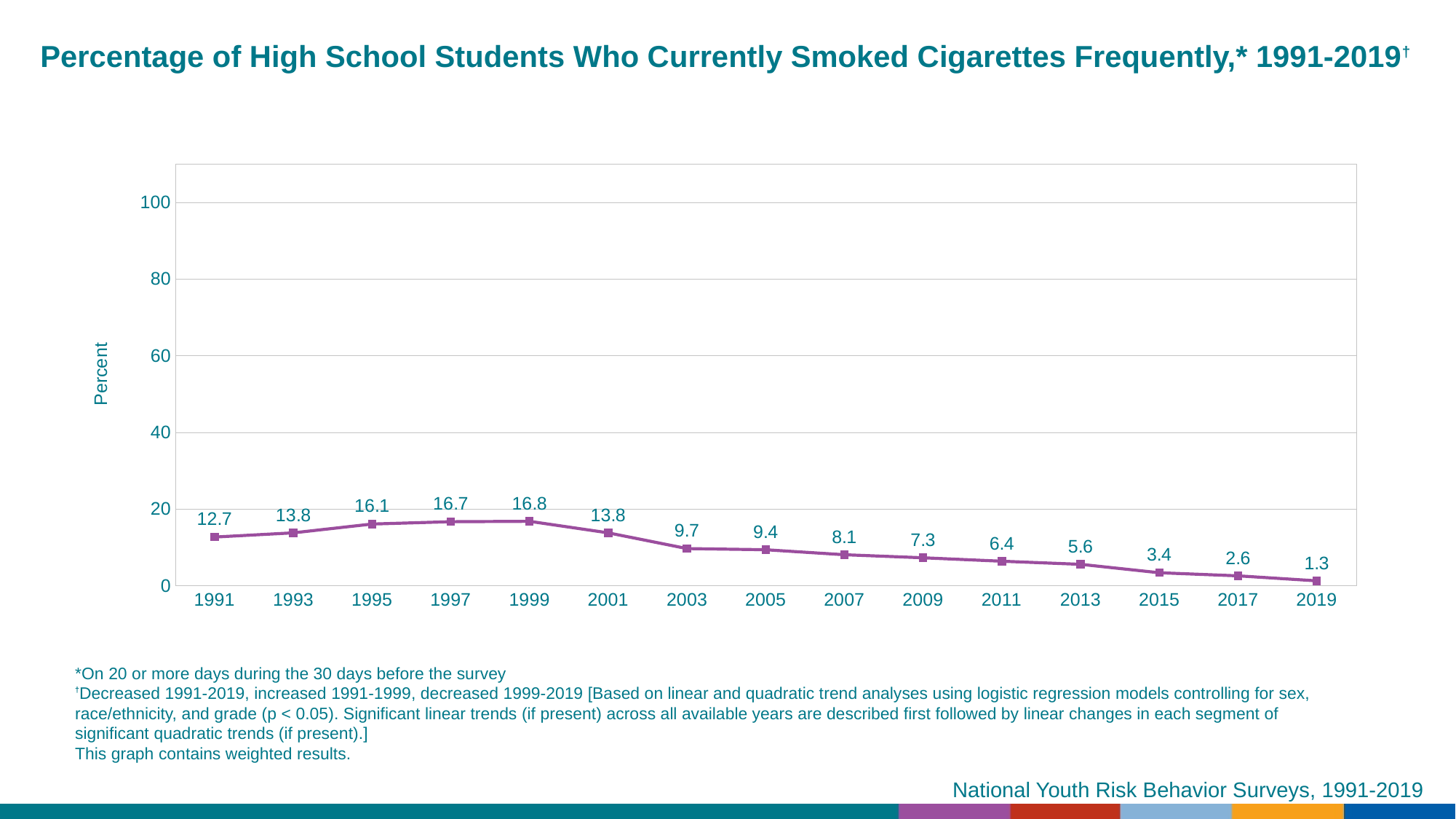
What is the difference between the values for 1991 and 2019? 11.4 How many years are plotted on the x axis? 15 What is the value plotted for 2007? 8.1 What percentage of high school students currently smoked cigarettes frequently in 1999? 16.8 Do the values rise or fall from 1999 to 2019? fall What is the value plotted for 2019? 1.3 Which year has the lowest percentage on the chart? 2019 What is the difference between the values for 2001 and 2003? 4.1 Which year has a larger value, 1995 or 2005? 1995 Is the value for 1997 greater or less than 20? less Which year has the highest percentage on the chart? 1999 What kind of chart is shown on the slide? line chart